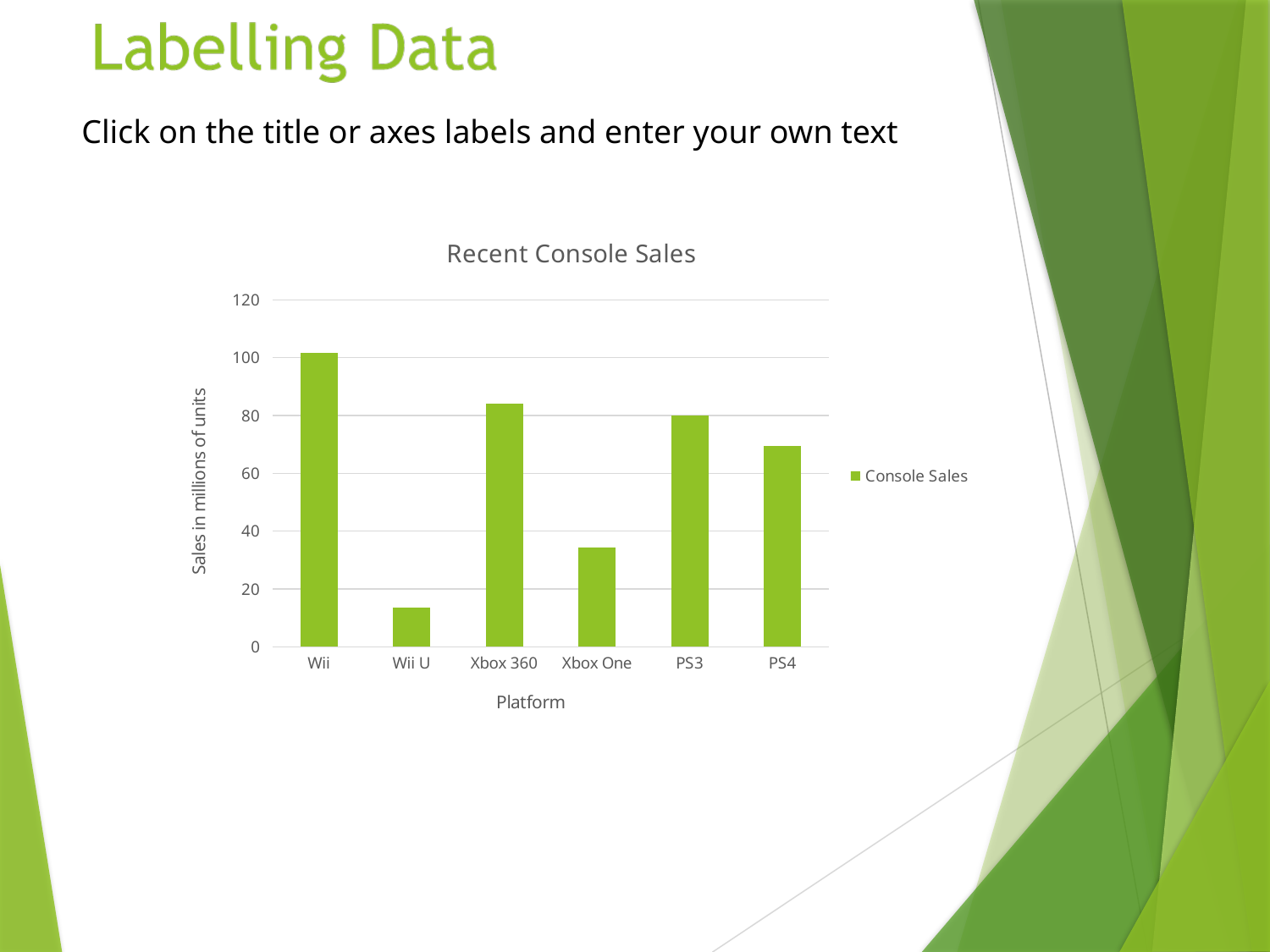
Is the value for Wii U greater or less than 20? less What is the label on the vertical axis of the chart? Sales in millions of units What kind of chart is shown on the slide? bar chart How many platforms are shown on the x axis of the chart? 6 Is the value for PS4 greater or less than 60? greater Which platform has the lowest console sales in the chart? Wii U Which platform has the highest console sales in the chart? Wii Which has higher console sales, PS3 or PS4? PS3 Is the value for Xbox One greater or less than 40? less How many series does the chart's legend list? 1 Which has higher console sales, Xbox 360 or Xbox One? Xbox 360 What is the title of the chart? Recent Console Sales